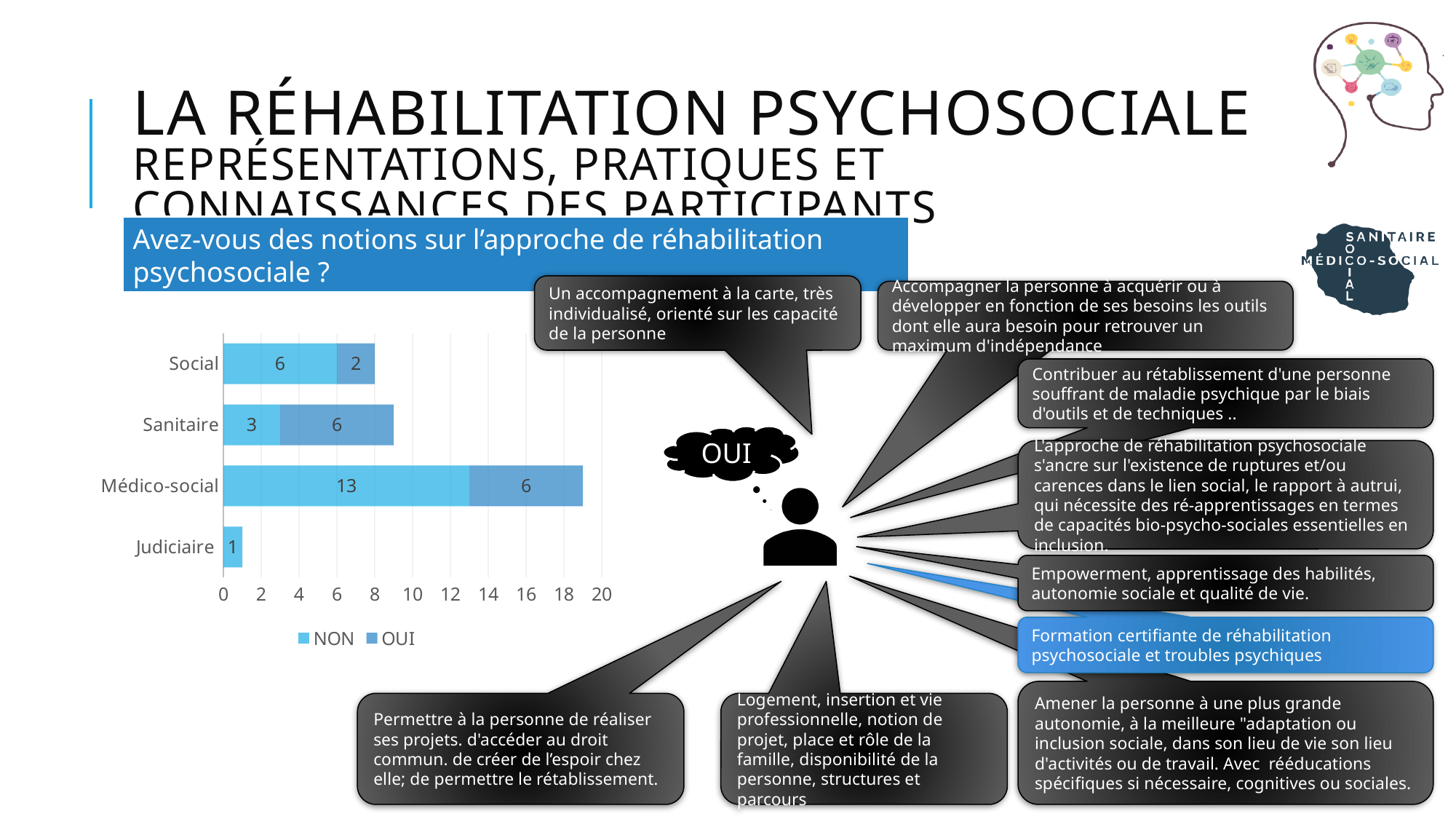
What is the OUI value for Sanitaire? 6 Which category has the highest NON value? Médico-social Which is larger for Social, the NON value or the OUI value? NON What is the OUI value for Social? 2 What is the difference between the NON and OUI values for Médico-social? 7 How many series does the chart legend list? 2 How many categories are shown on the chart? 4 What is the NON value for Judiciaire? 1 What type of chart is shown on the slide? bar chart Which category has the lowest NON value? Judiciaire What is the NON value for Médico-social? 13 What is the total of the stacked bar for Sanitaire? 9